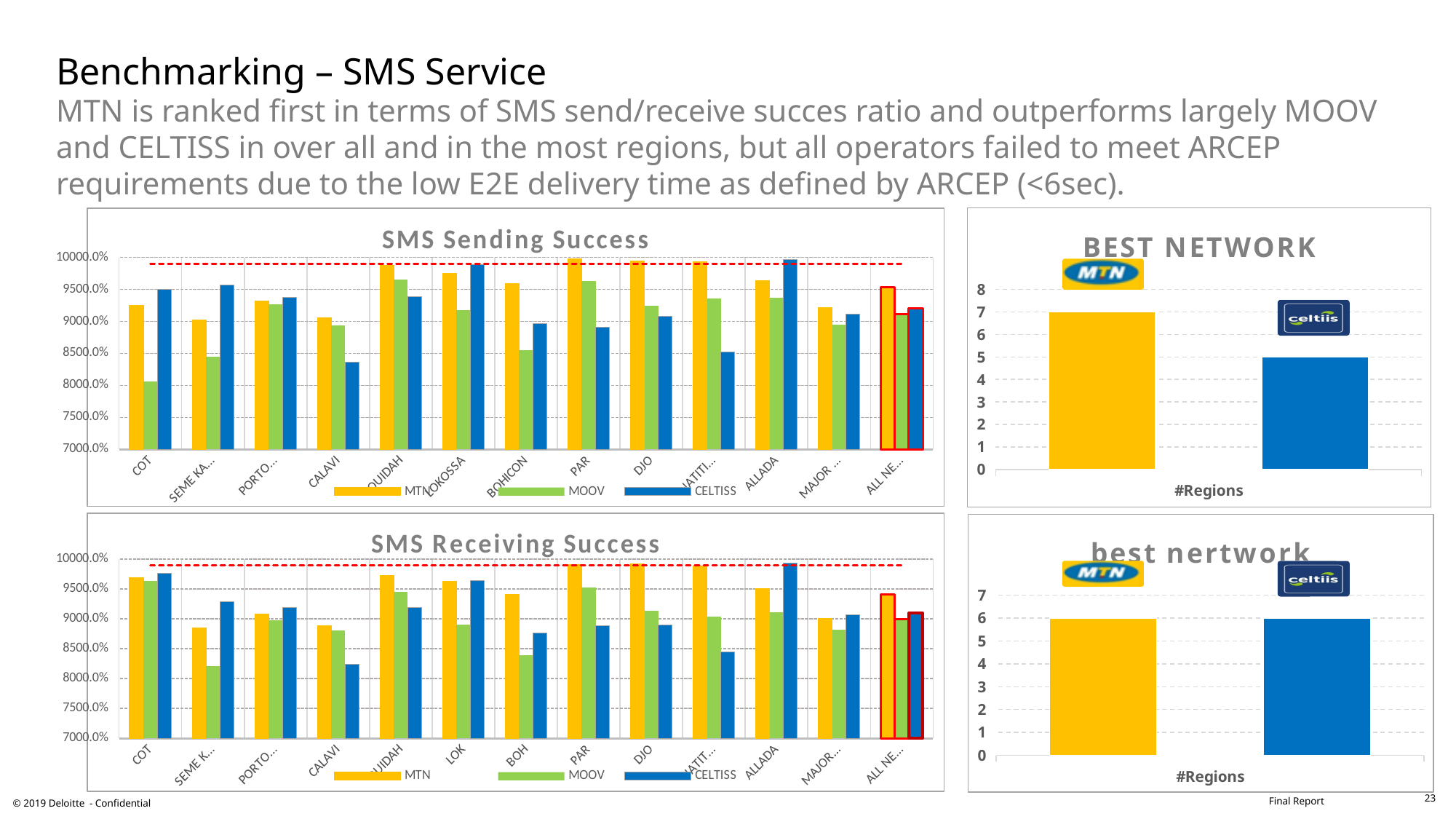
In the "BEST NETWORK" chart (top right), which operator has the higher bar? MTN In the "best nertwork" chart (bottom right), what is the number of regions for MTN? 6 How many categories are shown on the x axis of the "SMS Sending Success" chart? 13 In the "SMS Sending Success" chart, which is larger for COT: MTN or MOOV? MTN In the "BEST NETWORK" chart (top right), what is the number of regions for MTN? 7 How many series does the legend of the "SMS Sending Success" chart list? 3 What kind of chart is the "SMS Sending Success" chart? bar chart In the "SMS Receiving Success" chart, is the CELTISS value for ALLADA greater or less than 9500.0%? greater In the "SMS Receiving Success" chart, is the MOOV value for SEME K... greater or less than 8500.0%? less What are the legend entries of the "SMS Receiving Success" chart? MTN, MOOV, CELTISS In the "SMS Sending Success" chart, is the MOOV value for COT greater or less than 8500.0%? less